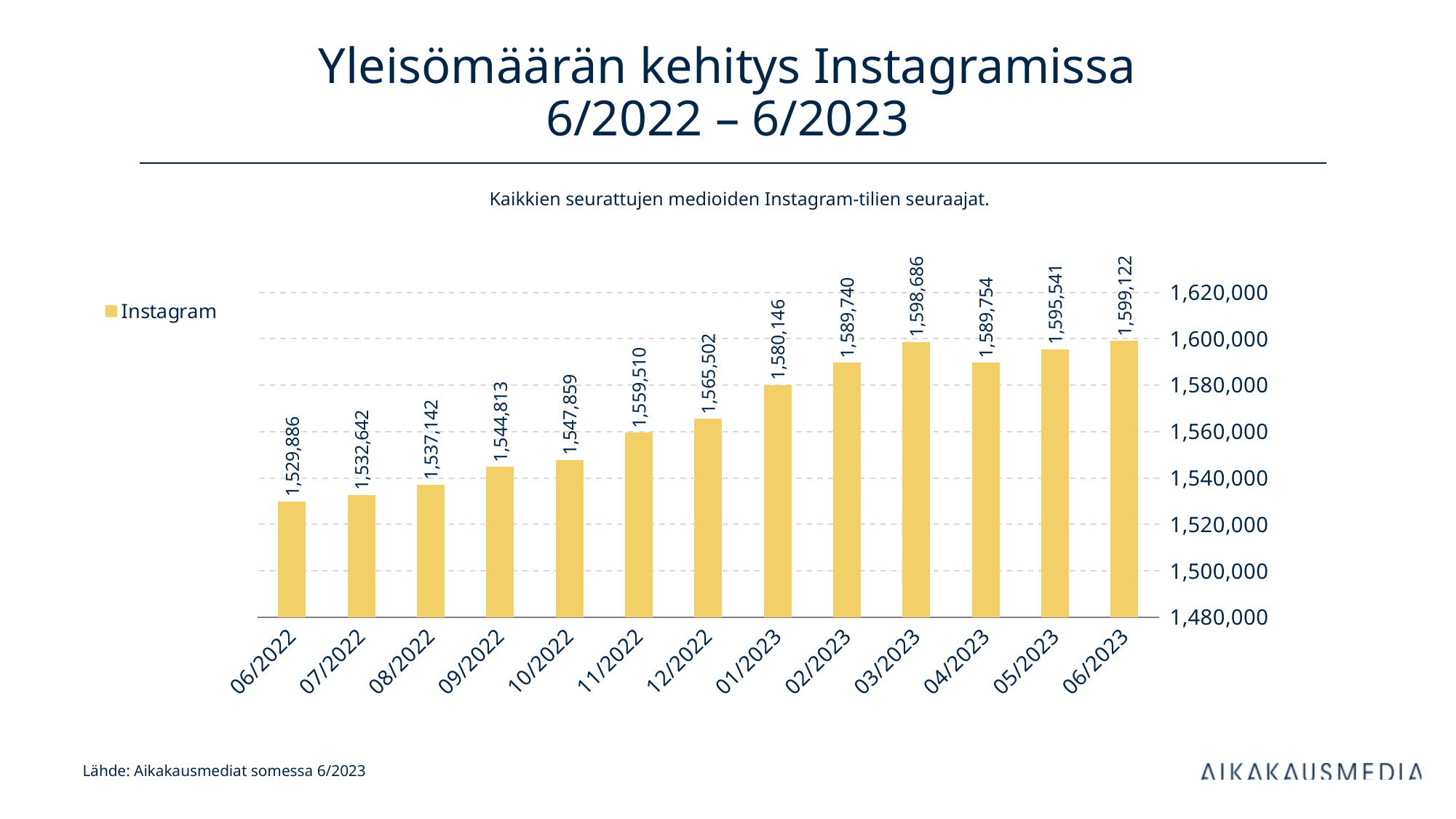
What type of chart is shown on the slide? bar chart What is the number of Instagram followers shown for 06/2022? 1,529,886 What is the difference between the values for 06/2023 and 06/2022? 69,236 Is the value for 10/2022 greater or less than 1,560,000? less Which month has the highest value in the chart? 06/2023 What value is shown for 03/2023? 1,598,686 How many months are shown on the x axis? 13 What is the difference between the values for 01/2023 and 12/2022? 14,644 What series name is listed in the legend? Instagram Which is larger, the value for 11/2022 or the value for 12/2022? 12/2022 Which month has the lowest value in the chart? 06/2022 What value is shown for 01/2023? 1,580,146